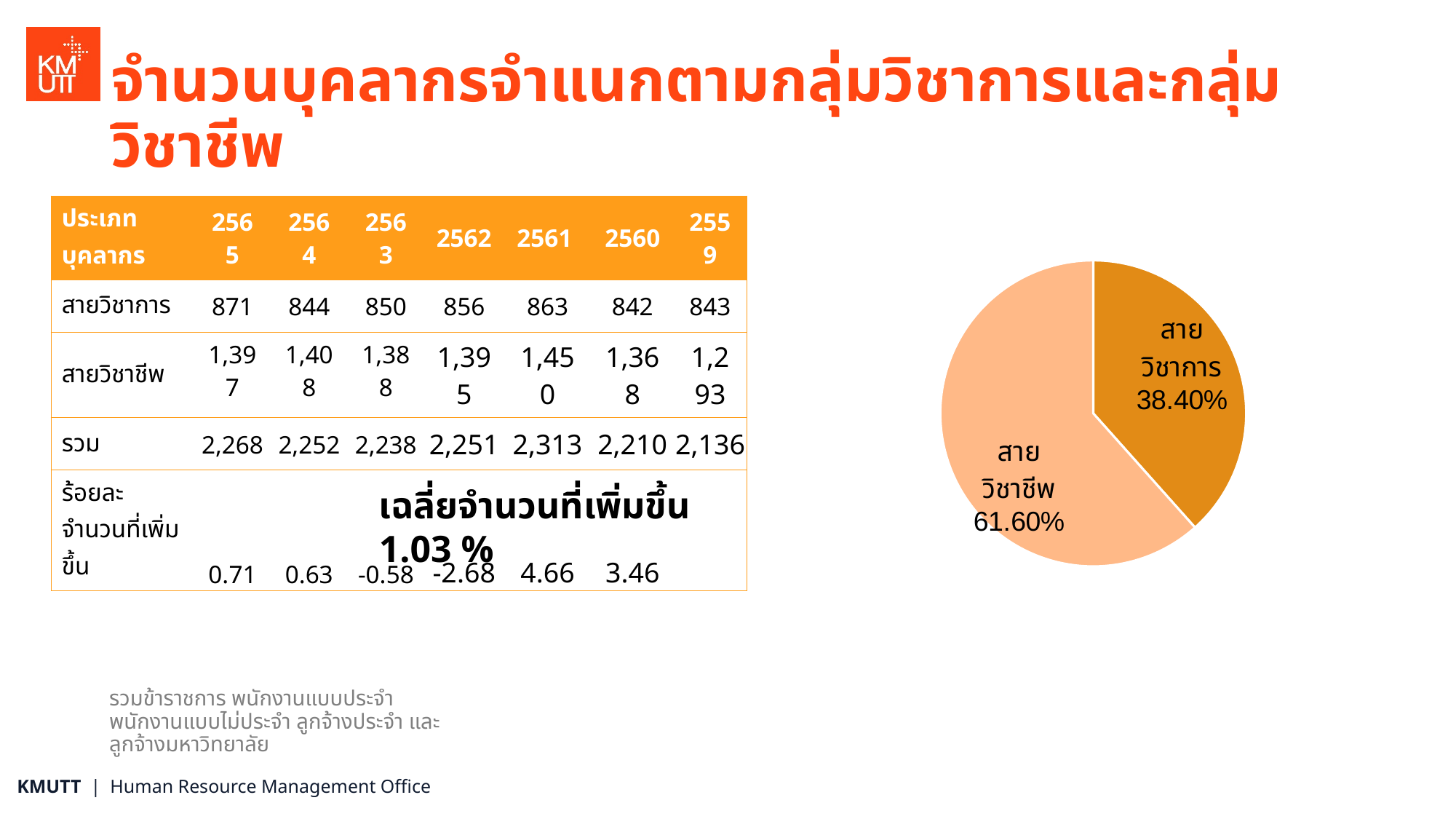
Which group has the largest share in the pie chart? สายวิชาชีพ Is the share for สายวิชาการ in the pie chart greater or less than 50%? less In the pie chart, which is larger: the share for สายวิชาการ or the share for สายวิชาชีพ? สายวิชาชีพ What percentage does the pie chart show for สายวิชาการ? 38.40% How many slices does the pie chart have? 2 What is the difference in percentage points between the สายวิชาชีพ slice and the สายวิชาการ slice in the pie chart? 23.20% What percentage does the pie chart show for สายวิชาชีพ? 61.60% What kind of chart is shown on the slide? pie chart What share of the pie does the สายวิชาชีพ slice represent? 61.60% Which slice of the pie chart is drawn in the darker orange colour? สายวิชาการ Which group has the smallest share in the pie chart? สายวิชาการ